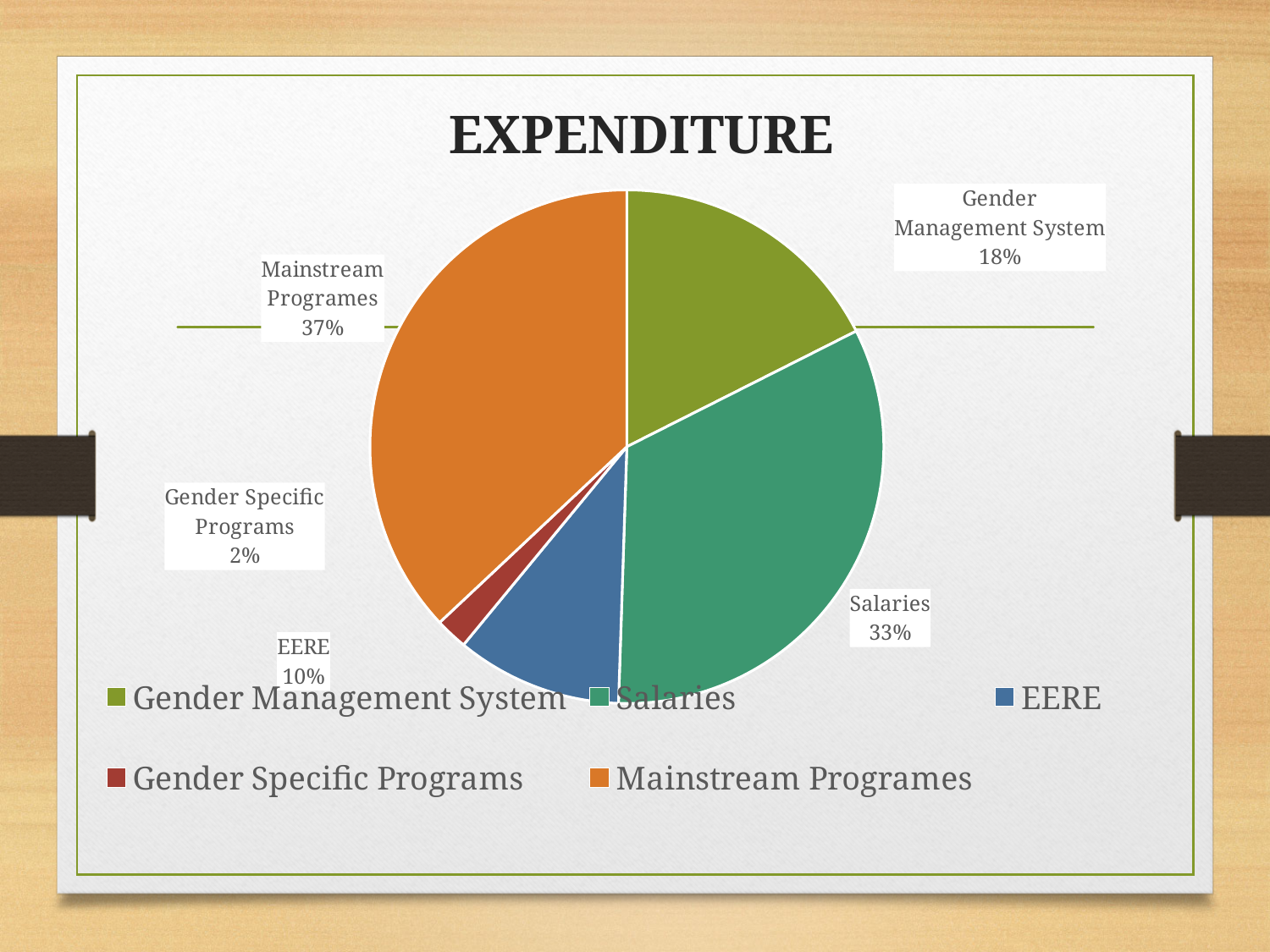
Which category has the largest share of expenditure? Mainstream Programes What is the title of the chart? EXPENDITURE What percentage is shown for Gender Management System? 18% What is the difference in percentage points between Salaries and Gender Management System? 15 Which is larger, the share for EERE or the share for Gender Management System? Gender Management System How many categories are shown in the pie chart? 5 What share of expenditure goes to Salaries? 33% What percentage is shown for Gender Specific Programs? 2% Which category has the smallest share of expenditure? Gender Specific Programs What percentage is shown for EERE? 10% What type of chart is shown on the slide? pie chart What share of expenditure goes to Mainstream Programes? 37%